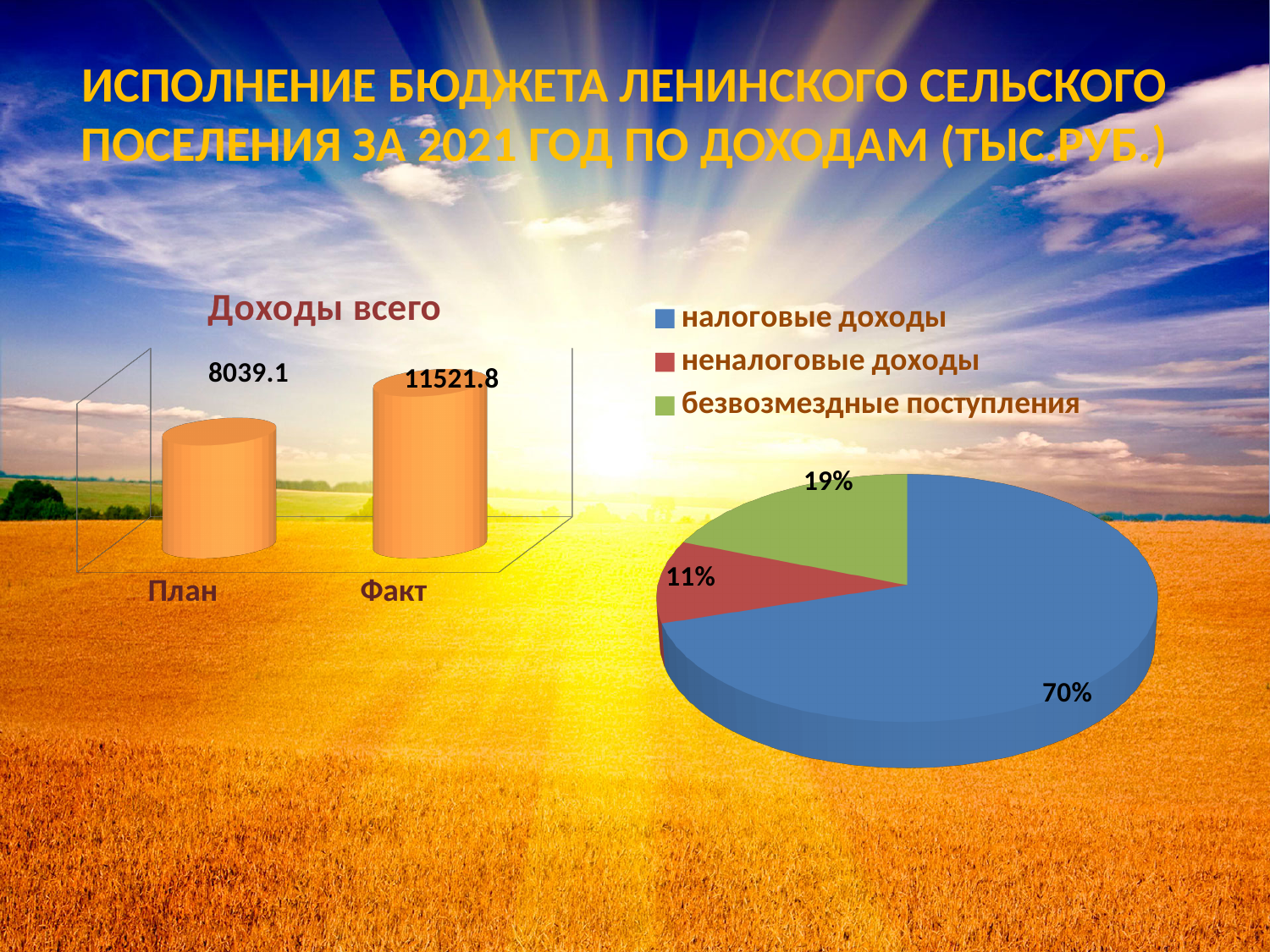
In the 'Доходы всего' chart, which category has the higher value? Факт In the 'Доходы всего' chart, what is the value for План? 8039.1 In the pie chart on the right, how many entries does the legend list? 3 In the pie chart on the right, which category has the smallest share? неналоговые доходы In the pie chart on the right, what share is неналоговые доходы? 11% In the pie chart on the right, what share is налоговые доходы? 70% In the 'Доходы всего' chart, what is the difference between Факт and План? 3482.7 In the pie chart on the right, what share is безвозмездные поступления? 19% In the pie chart on the right, what colour is the slice for налоговые доходы? blue In the 'Доходы всего' chart, how many categories are shown? 2 In the 'Доходы всего' chart, what is the value for Факт? 11521.8 What kind of chart is the 'Доходы всего' chart on the left? bar chart